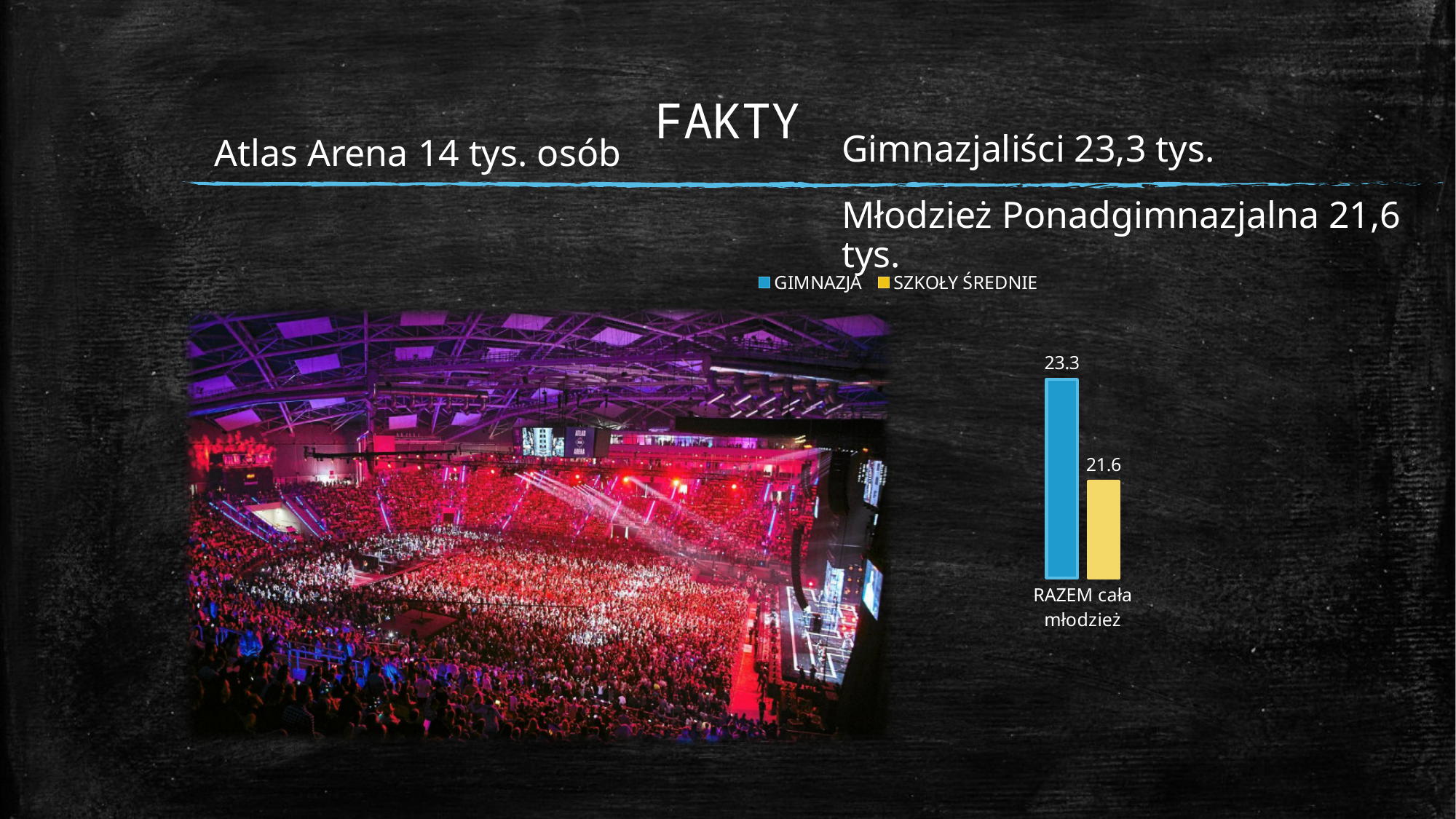
What is the value for GIMNAZJA in the chart? 23.3 How many series does the legend list? 2 What kind of chart is shown on the slide? bar chart What is the value for SZKOŁY ŚREDNIE in the chart? 21.6 What is the sum of the GIMNAZJA and SZKOŁY ŚREDNIE values? 44.9 What is the difference between the GIMNAZJA value and the SZKOŁY ŚREDNIE value? 1.7 Which series has the lowest value in the chart? SZKOŁY ŚREDNIE Which series has the higher value, GIMNAZJA or SZKOŁY ŚREDNIE? GIMNAZJA What is the category label shown under the bars? RAZEM cała młodzież How many categories are shown on the x axis of the chart? 1 What colour is the bar for SZKOŁY ŚREDNIE? yellow